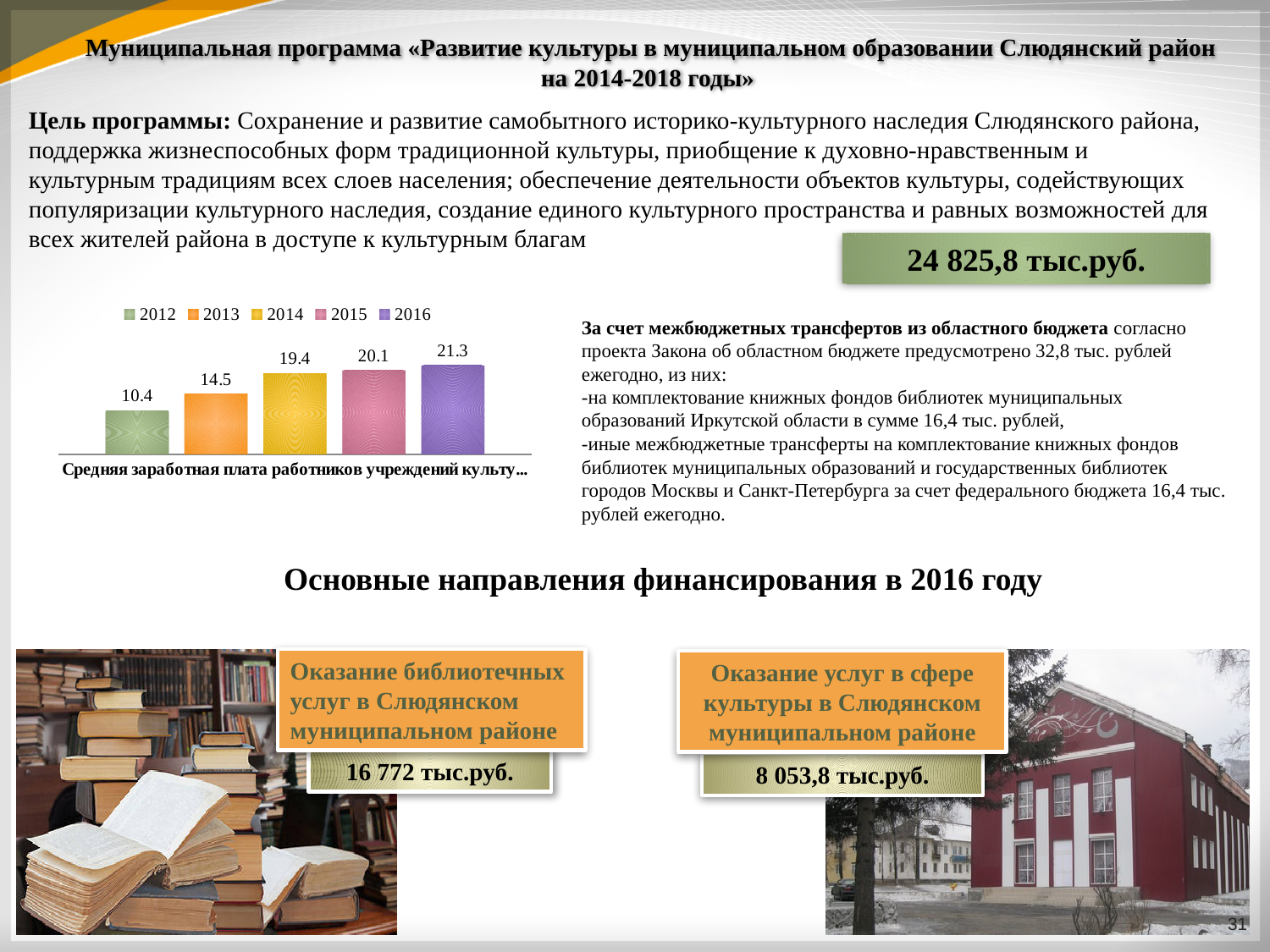
What is the value shown for 2016 on the chart? 21.3 Do the values on the chart rise or fall from 2012 to 2016? rise Which is larger, the value for 2013 or the value for 2015? 2015 What is the difference between the values for 2016 and 2012? 10.9 What kind of chart is shown on the slide? bar chart What is the value shown for 2014 on the chart? 19.4 Which year has the lowest value on the chart? 2012 Which year has the highest value on the chart? 2016 What is the value shown for 2012 on the chart? 10.4 How many entries does the chart legend list? 5 How many bars are plotted on the chart? 5 What is the difference between the values for 2013 and 2012? 4.1